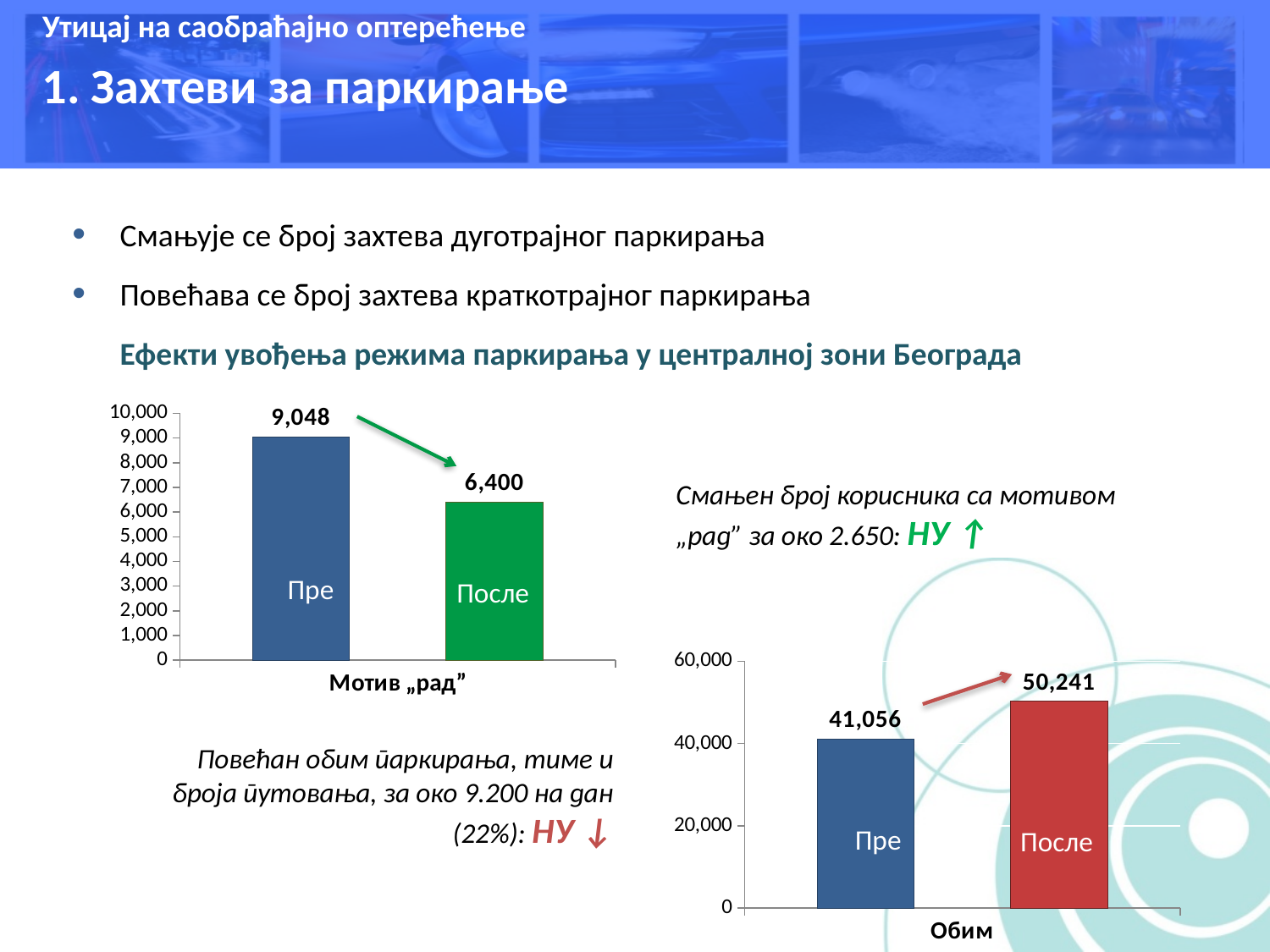
In the chart labelled Обим, which bar is the highest? После In the chart labelled Обим, what is the value for Пре? 41,056 In the chart labelled Обим, is the value for Пре greater or less than 40,000? greater How many bars are shown in the chart labelled Обим? 2 In the chart labelled Мотив „рад”, do the values rise or fall from Пре to После? fall In the chart labelled Обим, what is the value for После? 50,241 In the chart labelled Мотив „рад”, what is the value for После? 6,400 In the chart labelled Мотив „рад”, which bar is higher, Пре or После? Пре In the chart labelled Мотив „рад”, what is the difference between the Пре and После values? 2,648 In the chart labelled Мотив „рад”, what is the value for Пре? 9,048 What type of chart is the chart labelled Мотив „рад”? bar chart In the chart labelled Обим, what is the difference between the После and Пре values? 9,185